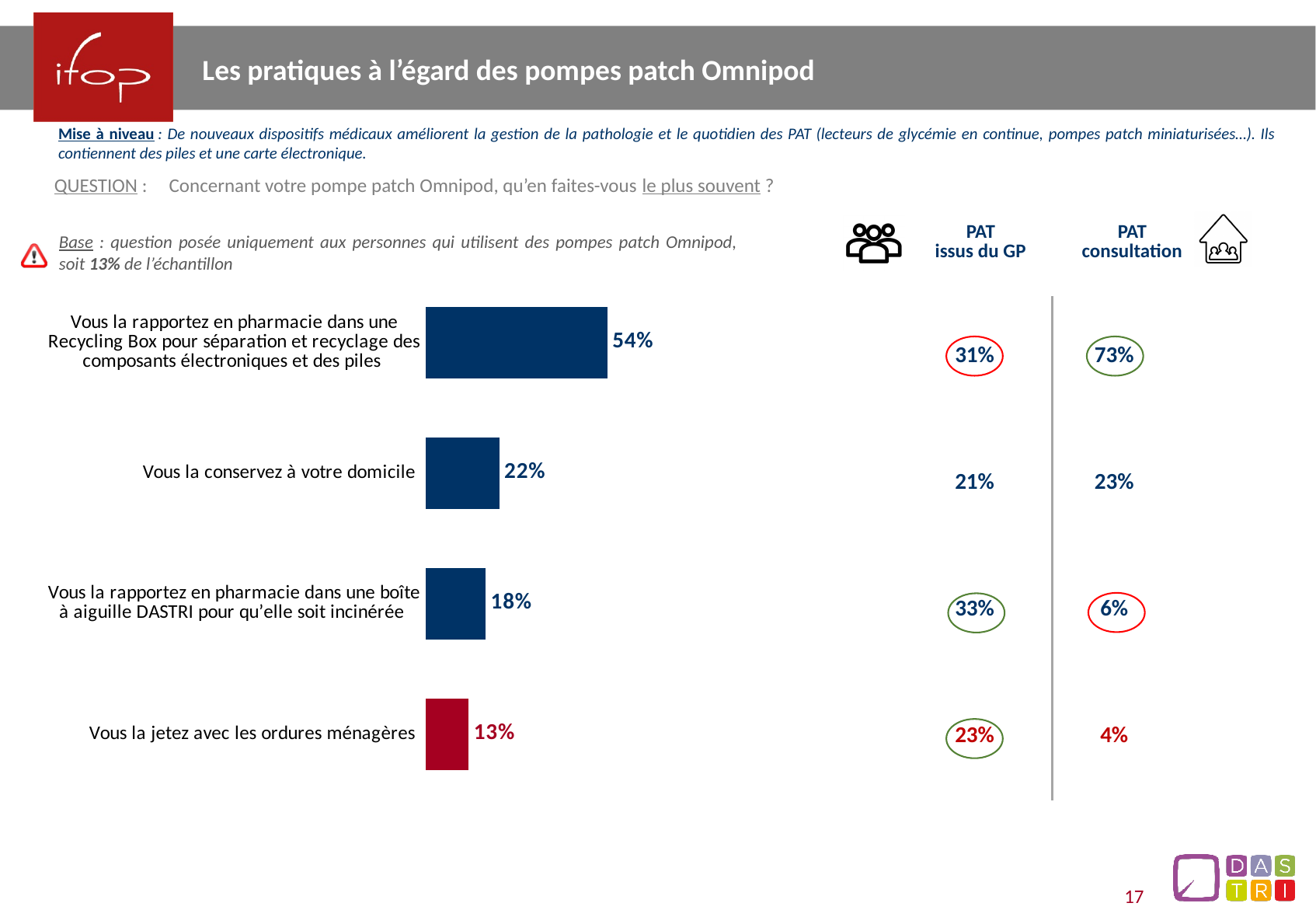
Which practice has the lowest percentage in the bar chart? Vous la jetez avec les ordures ménagères What is the difference in percentage points between bringing the pump back in a Recycling Box (54%) and keeping it at home (22%)? 32 What percentage of respondents say they keep the pump at home ("Vous la conservez à votre domicile")? 22% What percentage of respondents say they bring the Omnipod pump back to the pharmacy in a Recycling Box? 54% Which is larger: the share keeping the pump at home or the share bringing it back in a DASTRI needle box? Keeping the pump at home (22%) In the "PAT consultation" column, what percentage bring the pump back in a Recycling Box? 73% Which practice has the highest percentage in the bar chart? Vous la rapportez en pharmacie dans une Recycling Box pour séparation et recyclage des composants électroniques et des piles Which bar in the chart is coloured red rather than dark blue? Vous la jetez avec les ordures ménagères What type of chart is used to show the practices regarding Omnipod patch pumps? Bar chart What percentage of respondents say they bring the pump back to the pharmacy in a DASTRI needle box for incineration? 18% How many practices (categories) are shown in the bar chart? 4 What percentage of respondents say they throw the pump away with household waste ("ordures ménagères")? 13%